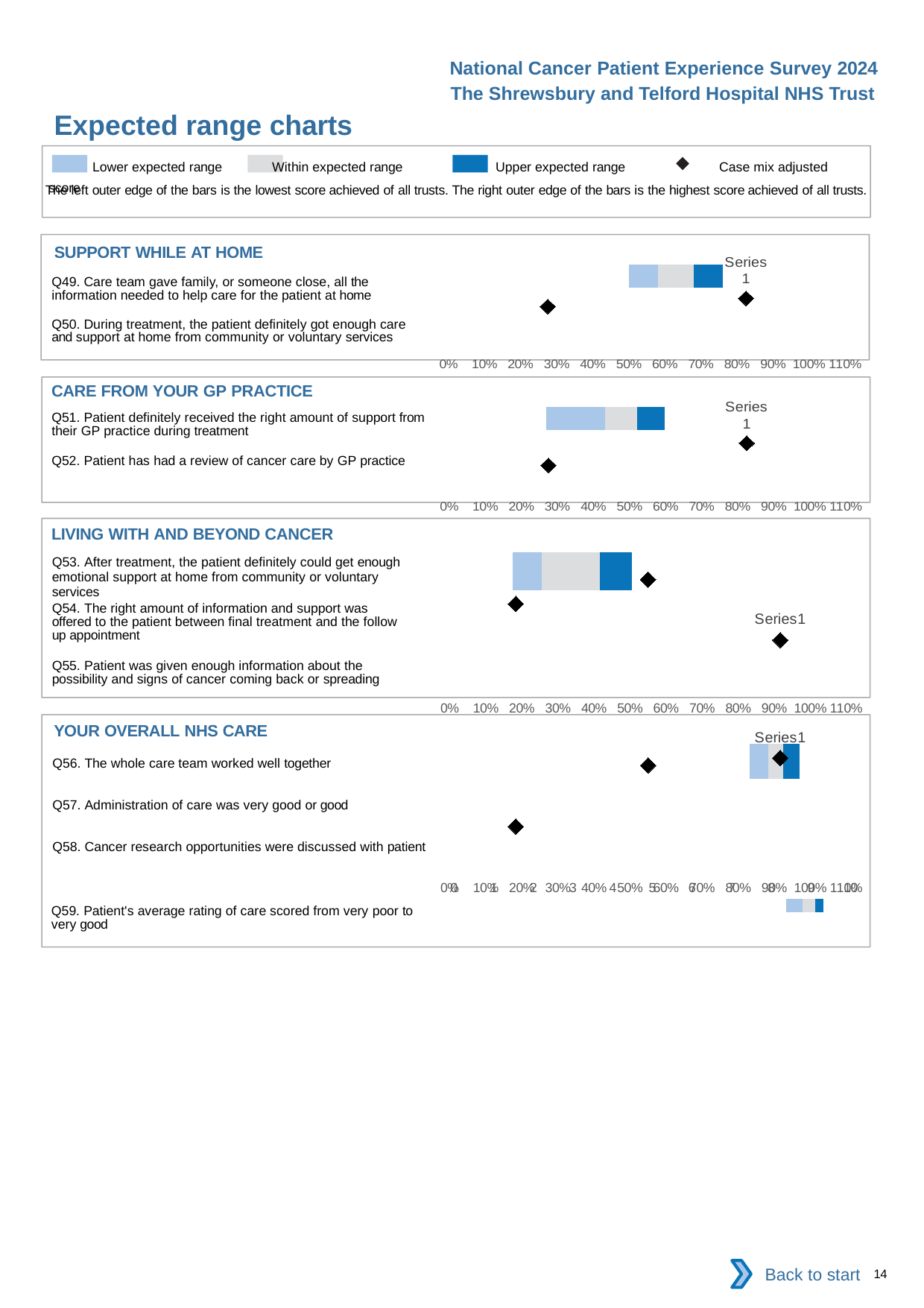
Which legend entry is represented by the black diamond marker? Case mix adjusted score Which legend entry is shown in dark blue? Upper expected range How many entries does the legend at the top of the slide list? 4 How many question categories are listed in the LIVING WITH AND BEYOND CANCER chart? 3 What kind of chart is used in the SUPPORT WHILE AT HOME section? bar chart In the CARE FROM YOUR GP PRACTICE chart, is the rightmost diamond marker greater or less than 70%? greater In the SUPPORT WHILE AT HOME chart, is the leftmost diamond marker greater or less than 50%? less In the LIVING WITH AND BEYOND CANCER chart, is the leftmost diamond marker greater or less than 40%? less How many section charts are shown on the slide? 4 What is the highest value labelled on the x axis of the SUPPORT WHILE AT HOME chart? 110% How many question categories are listed in the YOUR OVERALL NHS CARE chart? 4